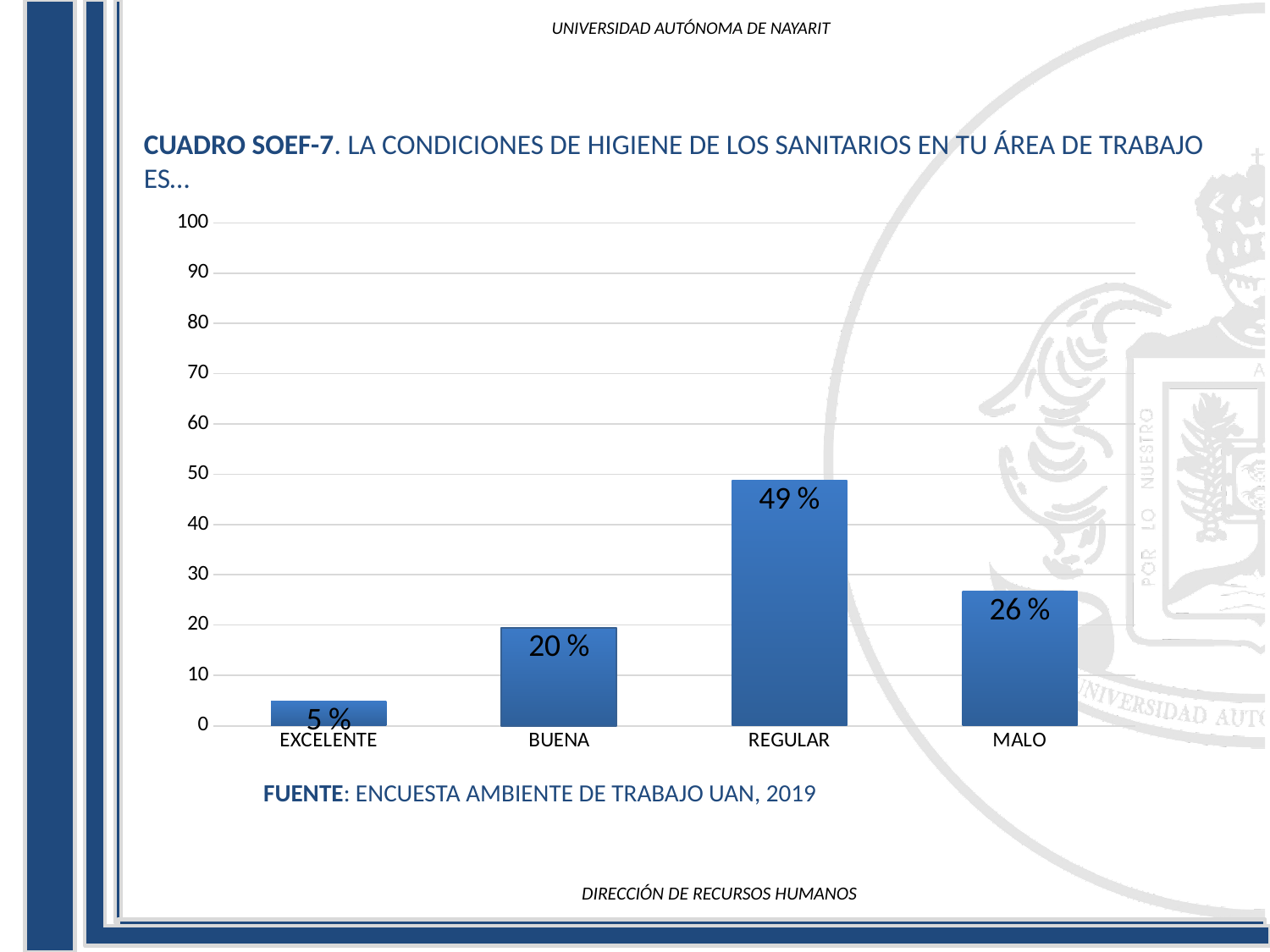
Which is larger, the value for BUENA or the value for MALO? MALO What is the value for EXCELENTE? 5 % What is the value for BUENA? 20 % How many categories are shown on the x axis? 4 Is the value for REGULAR greater or less than 40? greater Which category has the highest value? REGULAR Which category has the lowest value? EXCELENTE What is the value for REGULAR? 49 % What kind of chart is shown on the slide? bar chart What is the source cited below the chart? ENCUESTA AMBIENTE DE TRABAJO UAN, 2019 What is the value for MALO? 26 % What is the difference between the values for REGULAR and MALO? 23 %